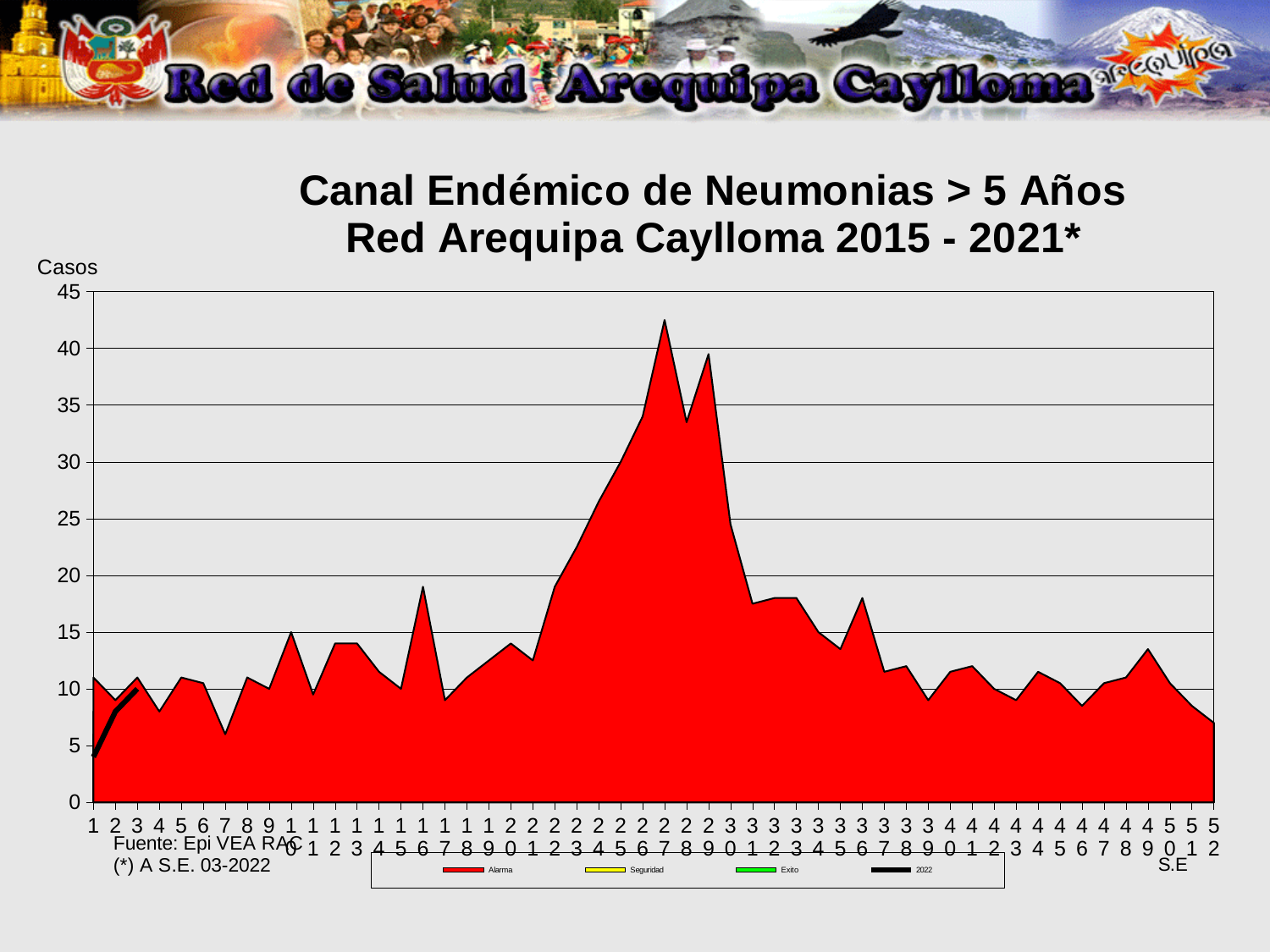
What kind of chart is shown on the slide? area chart At which week does the Alarma area reach its highest value? 27 Is the value of the Alarma area at week 7 greater or less than 10? less How many epidemiological weeks (S.E.) are shown along the x axis? 52 Is the value of the Alarma area at week 30 greater or less than 20? greater How many series does the legend list? 4 Do the Alarma values rise or fall from week 20 to week 27? rise Which week has a larger Alarma value, week 16 or week 27? week 27 What is the label on the y axis? Casos Is the value of the Alarma area at week 52 greater or less than 10? less Which legend entry is drawn in black? 2022